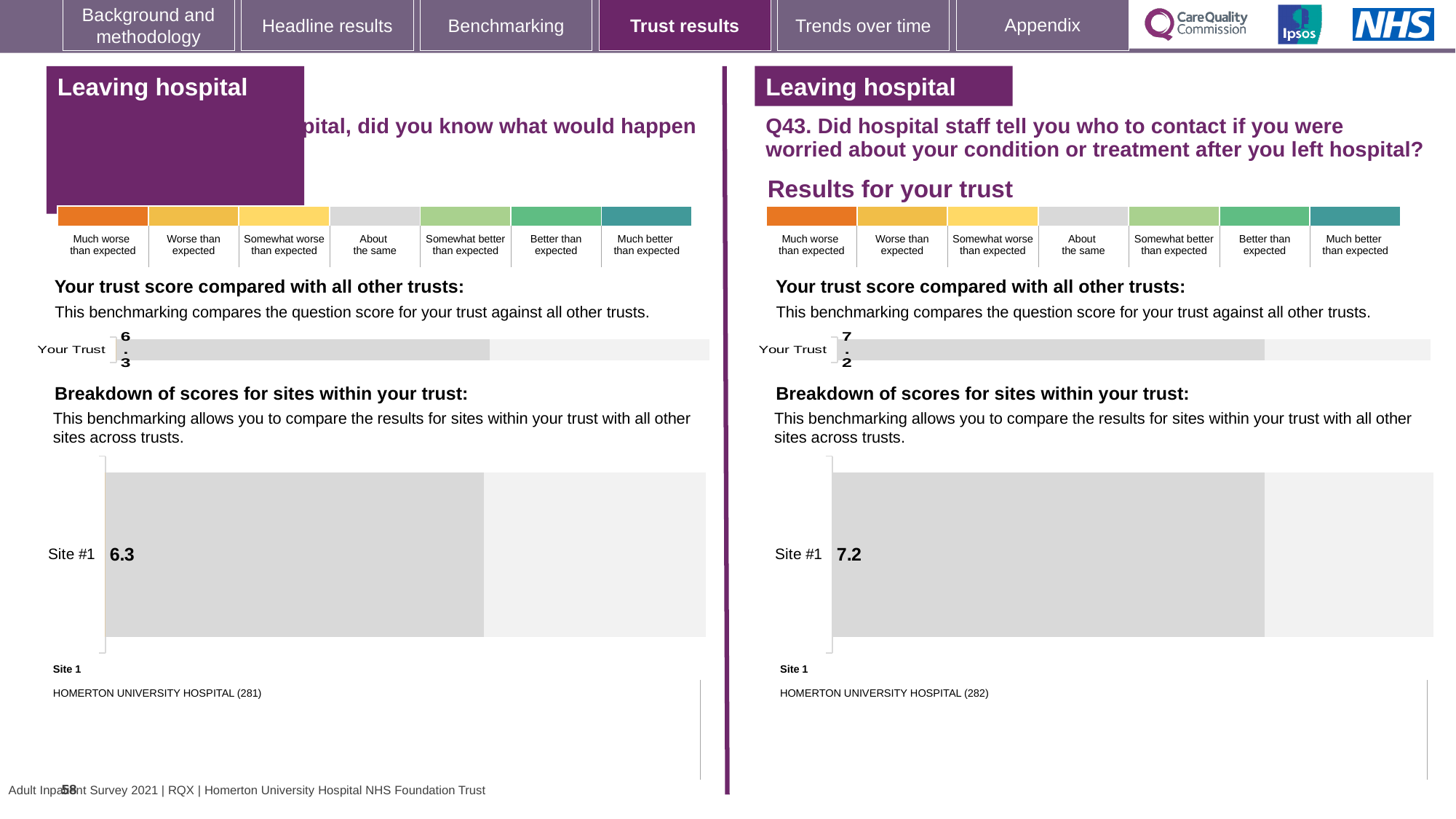
On the right-hand side (Q43), what is the score shown for Your Trust in the 'Your trust score compared with all other trusts' chart? 7.2 What kind of chart is used to show the Your Trust score on the left-hand side of the slide? Bar chart How many sites are shown in the 'Breakdown of scores for sites within your trust' chart on the right-hand side (Q43)? 1 On the left-hand side of the slide, what is the score shown for Site #1 in the 'Breakdown of scores for sites within your trust' chart? 6.3 Which is larger: the Site #1 score on the left-hand side of the slide or the Site #1 score on the right-hand side (Q43)? Right-hand side (Q43), 7.2 Which site name is listed as Site 1 below the chart on the right-hand side (Q43)? HOMERTON UNIVERSITY HOSPITAL (282) What kind of chart is used to show the Site #1 score on the right-hand side (Q43)? Bar chart What is the difference between the Your Trust score on the right-hand side (Q43) and the Your Trust score on the left-hand side of the slide? 0.9 How many sites are shown in the 'Breakdown of scores for sites within your trust' chart on the left-hand side of the slide? 1 On the left-hand side of the slide, what is the score shown for Your Trust in the 'Your trust score compared with all other trusts' chart? 6.3 On the right-hand side (Q43), what is the score shown for Site #1 in the 'Breakdown of scores for sites within your trust' chart? 7.2 Which site name is listed as Site 1 below the chart on the left-hand side of the slide? HOMERTON UNIVERSITY HOSPITAL (281)